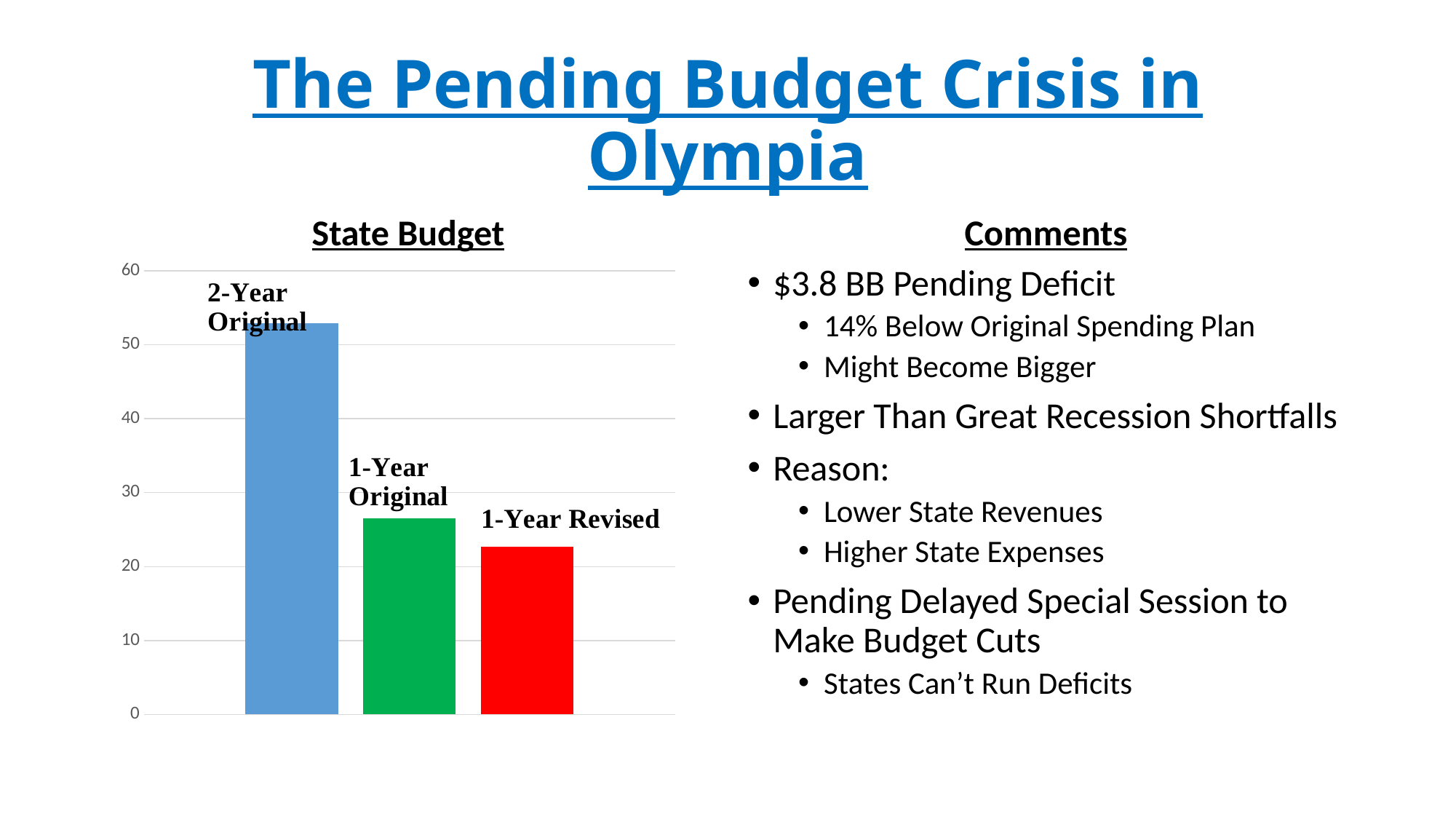
Do the bar values in the State Budget chart rise or fall from left to right? fall In the State Budget chart, which is larger: 2-Year Original or 1-Year Original? 2-Year Original In the State Budget chart, which is larger: 1-Year Original or 1-Year Revised? 1-Year Original What is the highest tick value shown on the vertical axis of the State Budget chart? 60 What colour is the 1-Year Revised bar in the State Budget chart? red Which bar in the State Budget chart is the lowest? 1-Year Revised Which bar in the State Budget chart is the highest? 2-Year Original How many bars are plotted in the State Budget chart? 3 Is the value for 1-Year Revised in the State Budget chart greater or less than 20? greater Is the value for 1-Year Original in the State Budget chart greater or less than 30? less What kind of chart is shown under the title "State Budget"? bar chart Is the value for 2-Year Original in the State Budget chart greater or less than 50? greater